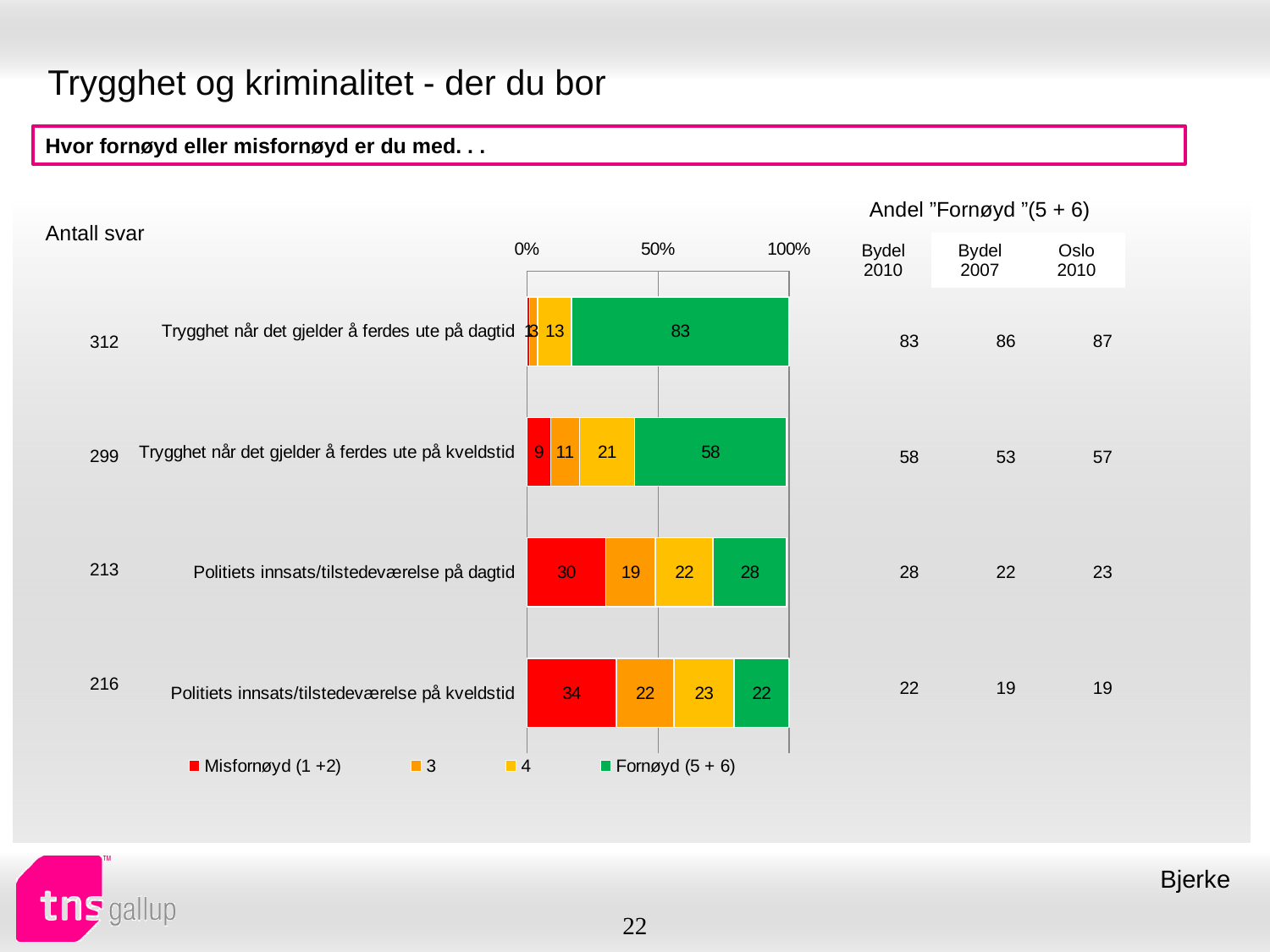
Which category has the highest Fornøyd (5 + 6) value? Trygghet når det gjelder å ferdes ute på dagtid Which colour represents Fornøyd (5 + 6) in the chart legend? green What kind of chart is shown on the slide? bar chart What is the value of series "4" for "Trygghet når det gjelder å ferdes ute på kveldstid"? 21 What is the difference between the Misfornøyd (1 +2) values for "Politiets innsats/tilstedeværelse på kveldstid" and "Politiets innsats/tilstedeværelse på dagtid"? 4 How many series does the chart legend list? 4 In the table to the right of the chart, what is the Bydel 2007 value for "Politiets innsats/tilstedeværelse på kveldstid"? 19 For "Politiets innsats/tilstedeværelse på dagtid", which is larger: the Misfornøyd (1 +2) value or the Fornøyd (5 + 6) value? Misfornøyd (1 +2) How many categories are plotted in the bar chart? 4 What is the Fornøyd (5 + 6) value for "Trygghet når det gjelder å ferdes ute på dagtid"? 83 What is the Misfornøyd (1 +2) value for "Politiets innsats/tilstedeværelse på kveldstid"? 34 Which category has the lowest Fornøyd (5 + 6) value? Politiets innsats/tilstedeværelse på kveldstid